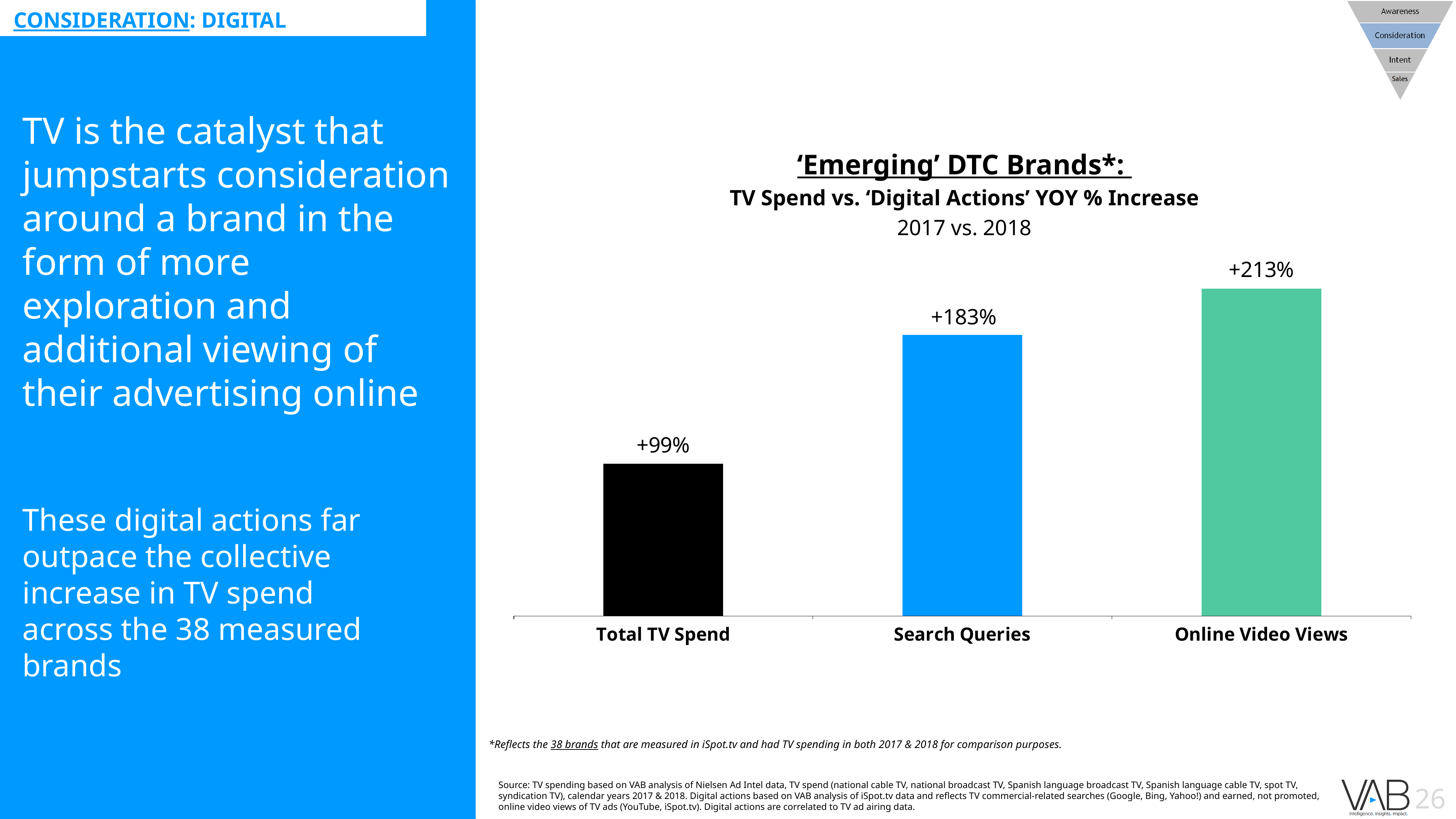
What is the difference in percentage points between the Search Queries increase and the Total TV Spend increase? 84 What is the YOY % increase shown for Online Video Views? +213% What is the YOY % increase shown for Search Queries? +183% Do the values rise or fall moving from left to right across the categories? Rise Which two years does the chart compare? 2017 vs. 2018 Which category has the highest YOY % increase? Online Video Views What is the YOY % increase shown for Total TV Spend? +99% What kind of chart is shown on the slide? Bar chart Which category has the lowest YOY % increase? Total TV Spend What is the difference in percentage points between the Online Video Views increase and the Total TV Spend increase? 114 Which is larger, the YOY % increase for Search Queries or for Online Video Views? Online Video Views How many categories are shown on the chart? 3